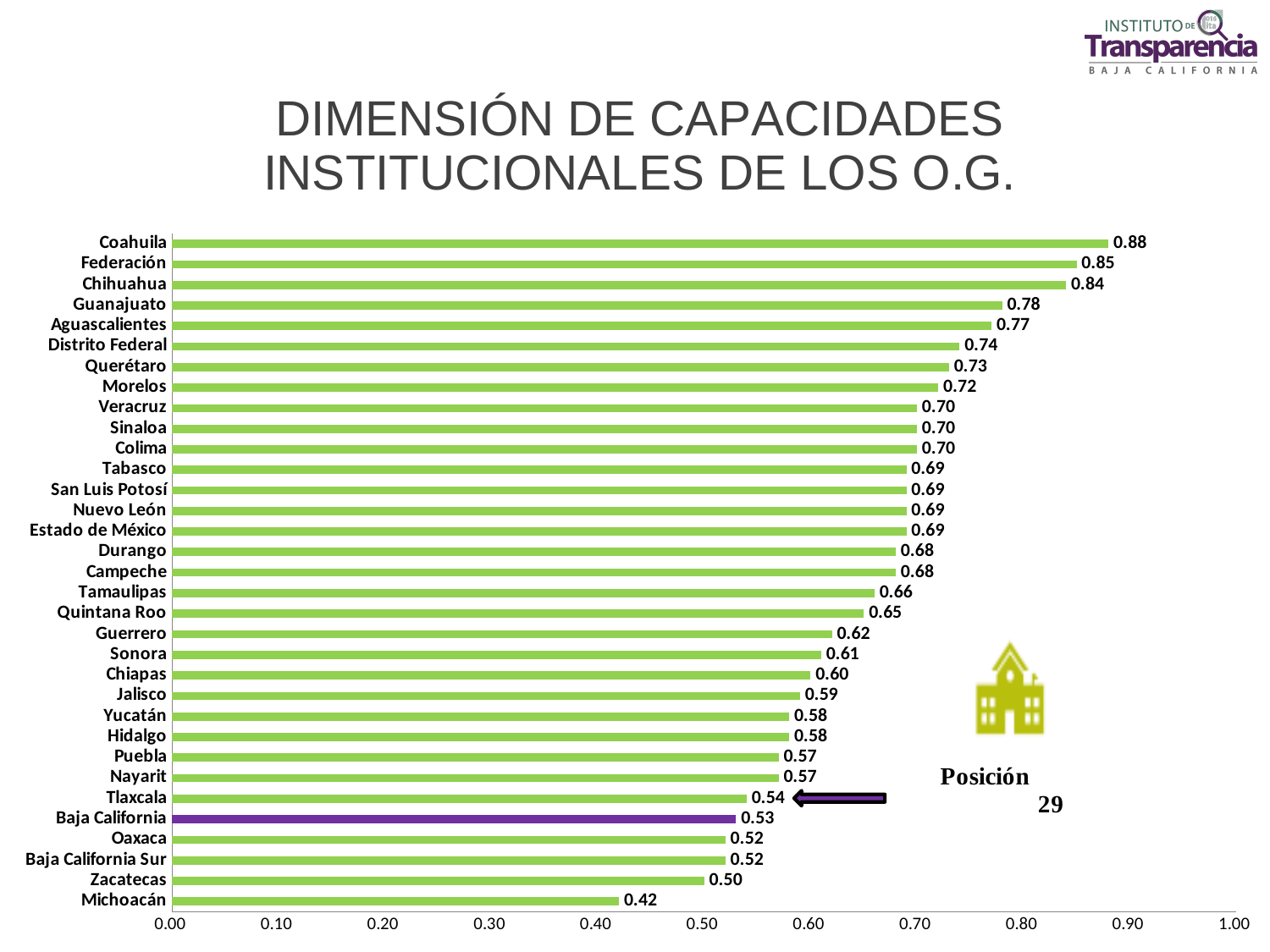
What is the value for Baja California? 0.53 How many categories are shown in the chart? 33 Which bar is highlighted in a different colour (purple) from the others? Baja California What kind of chart is shown on the slide? Bar chart Which category has the lowest value? Michoacán What is the difference between the values for Federación and Baja California? 0.32 What is the value for Coahuila? 0.88 Which is larger, the value for Chihuahua or the value for Distrito Federal? Chihuahua What is the difference between the values for Coahuila and Michoacán? 0.46 What is the value for Guanajuato? 0.78 What is the value for Michoacán? 0.42 Which category has the highest value? Coahuila